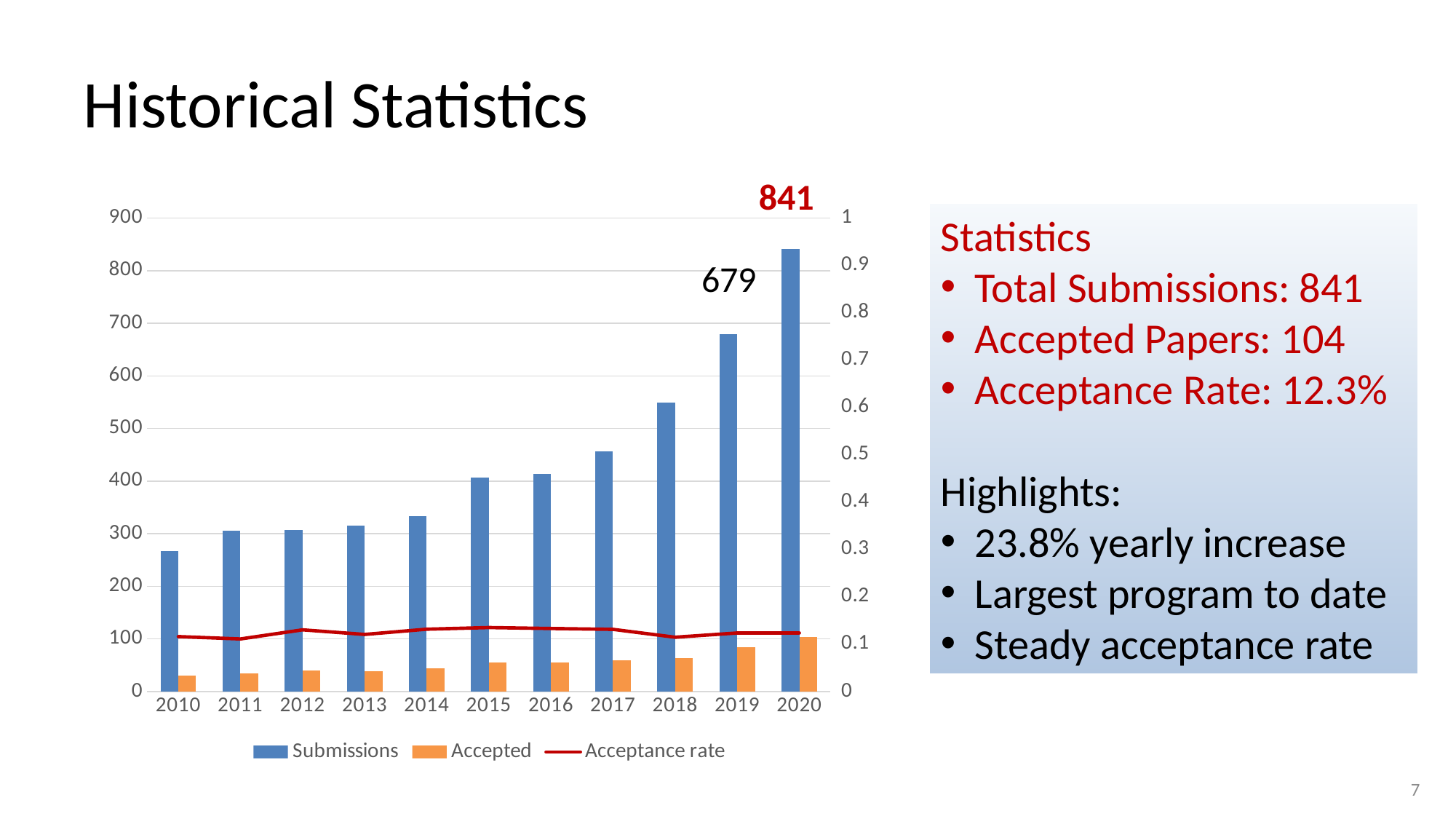
How many years are shown on the x axis of the chart? 11 What kind of chart is used to show Submissions and Accepted? bar chart Is the value for Submissions in 2010 greater or less than 300? less Do Submissions generally rise or fall from 2010 to 2020? rise Which year has the lowest number of Submissions? 2010 Which year has the highest number of Submissions? 2020 How many series does the chart legend list? 3 By how much did Submissions increase from 2019 to 2020? 162 Is the value for Submissions in 2018 greater or less than 500? greater Which series is drawn as a line in the chart? Acceptance rate What is the number of Submissions in 2019? 679 What is the number of Submissions in 2020? 841